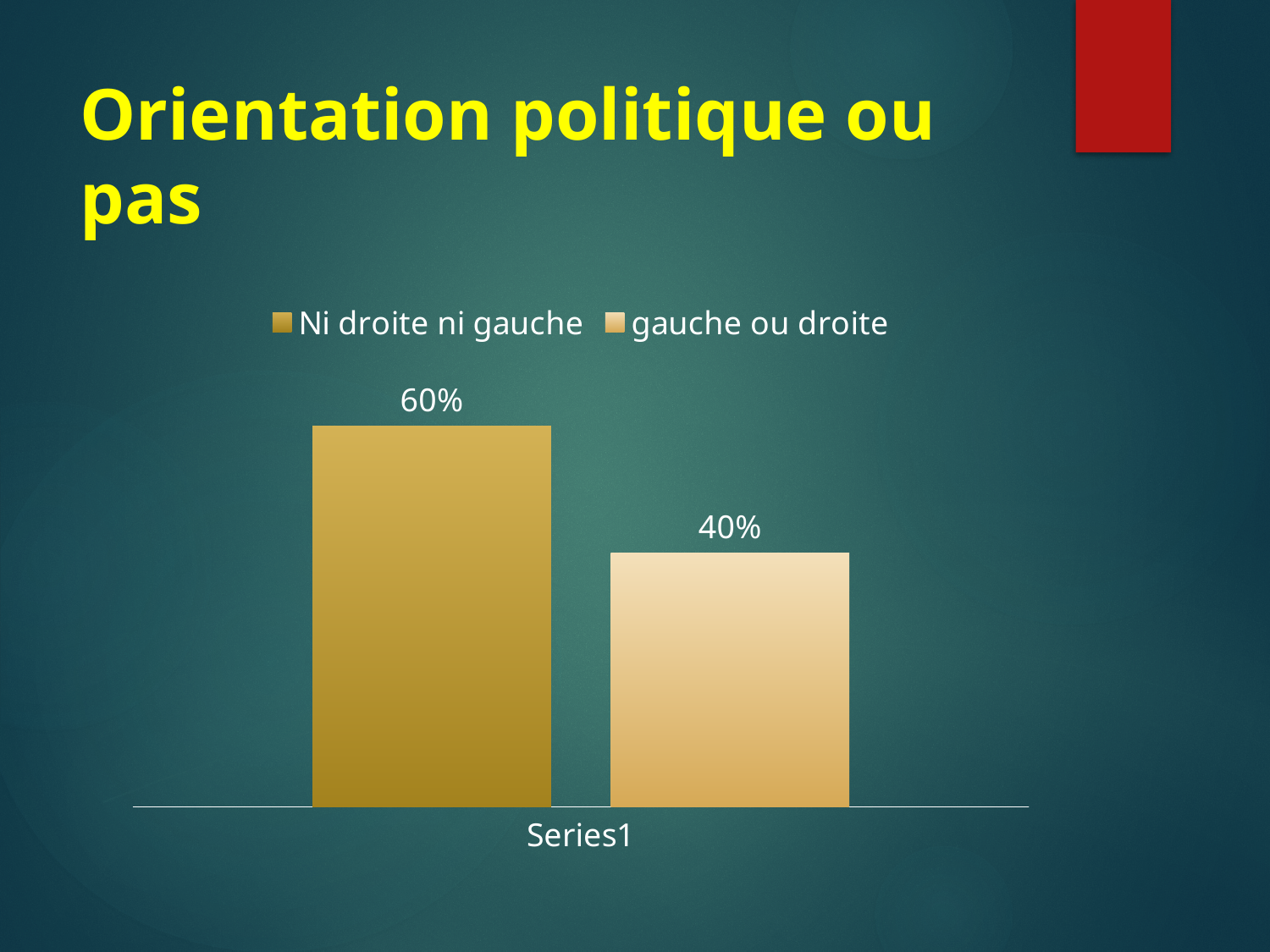
What is the value for "gauche ou droite"? 40% How many series does the legend list? 2 What is the difference between the values for "Ni droite ni gauche" and "gauche ou droite"? 20% Which series has the lowest value? gauche ou droite Which is larger, the value for "Ni droite ni gauche" or for "gauche ou droite"? Ni droite ni gauche Which series has the highest value? Ni droite ni gauche What is the title of the slide containing the chart? Orientation politique ou pas What is the value for "Ni droite ni gauche"? 60% What kind of chart is shown on the slide? Bar chart How many bars are plotted in the chart? 2 What is the category label shown on the x axis? Series1